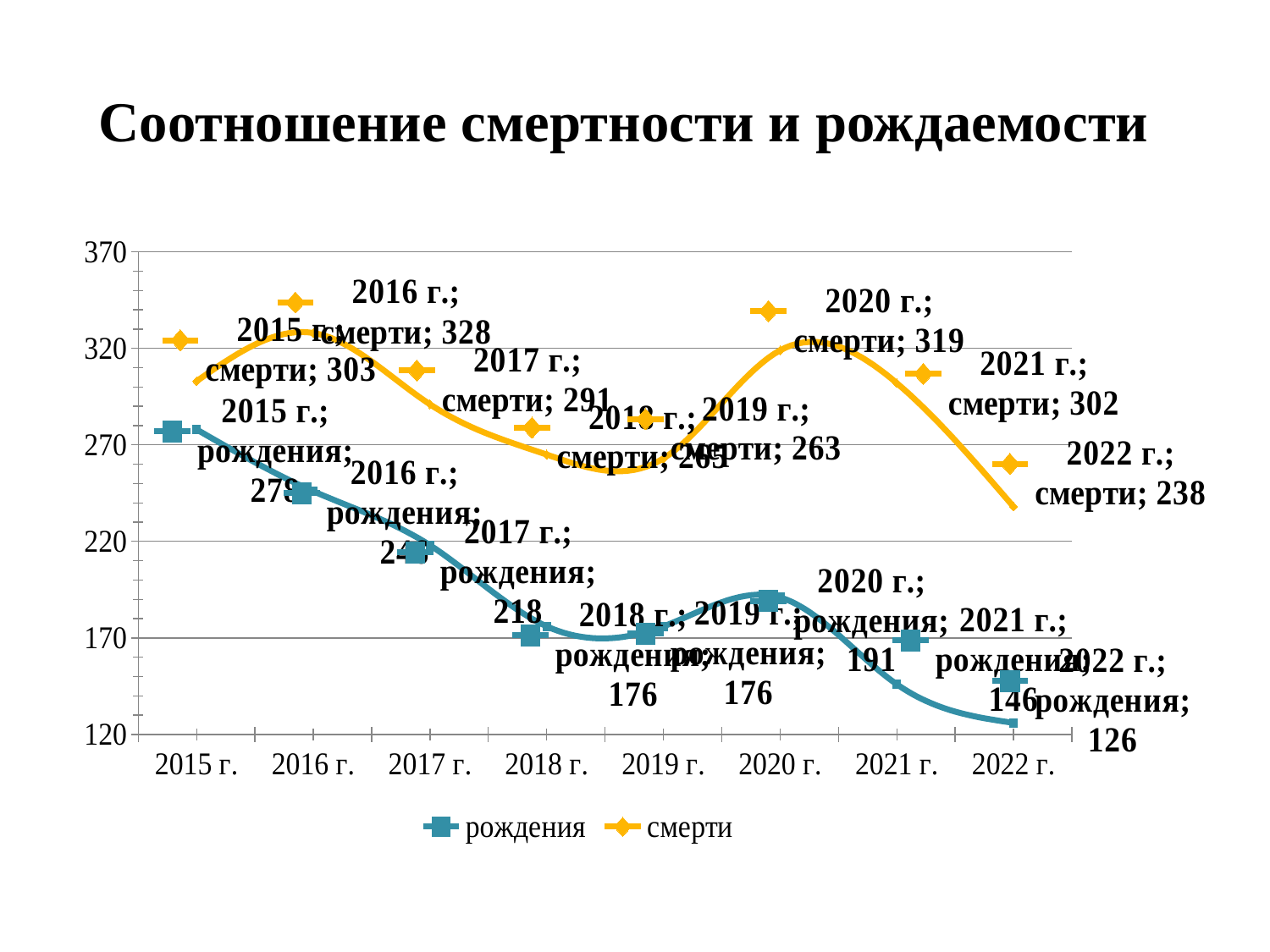
In which year is the value for смерти the highest? 2016 г. What is the difference between смерти and рождения in 2015 г.? 25 What is the value for смерти in 2020 г.? 319 What is the value for рождения in 2022 г.? 126 How many years are shown on the x axis? 8 In which year is the value for рождения the lowest? 2022 г. How many series does the legend list? 2 What is the value for смерти in 2016 г.? 328 Does the value for рождения generally rise or fall from 2015 г. to 2022 г.? fall What kind of chart is shown on the slide? line chart Which is larger: рождения in 2020 г. or рождения in 2021 г.? 2020 г. What is the title of the chart? Соотношение смертности и рождаемости